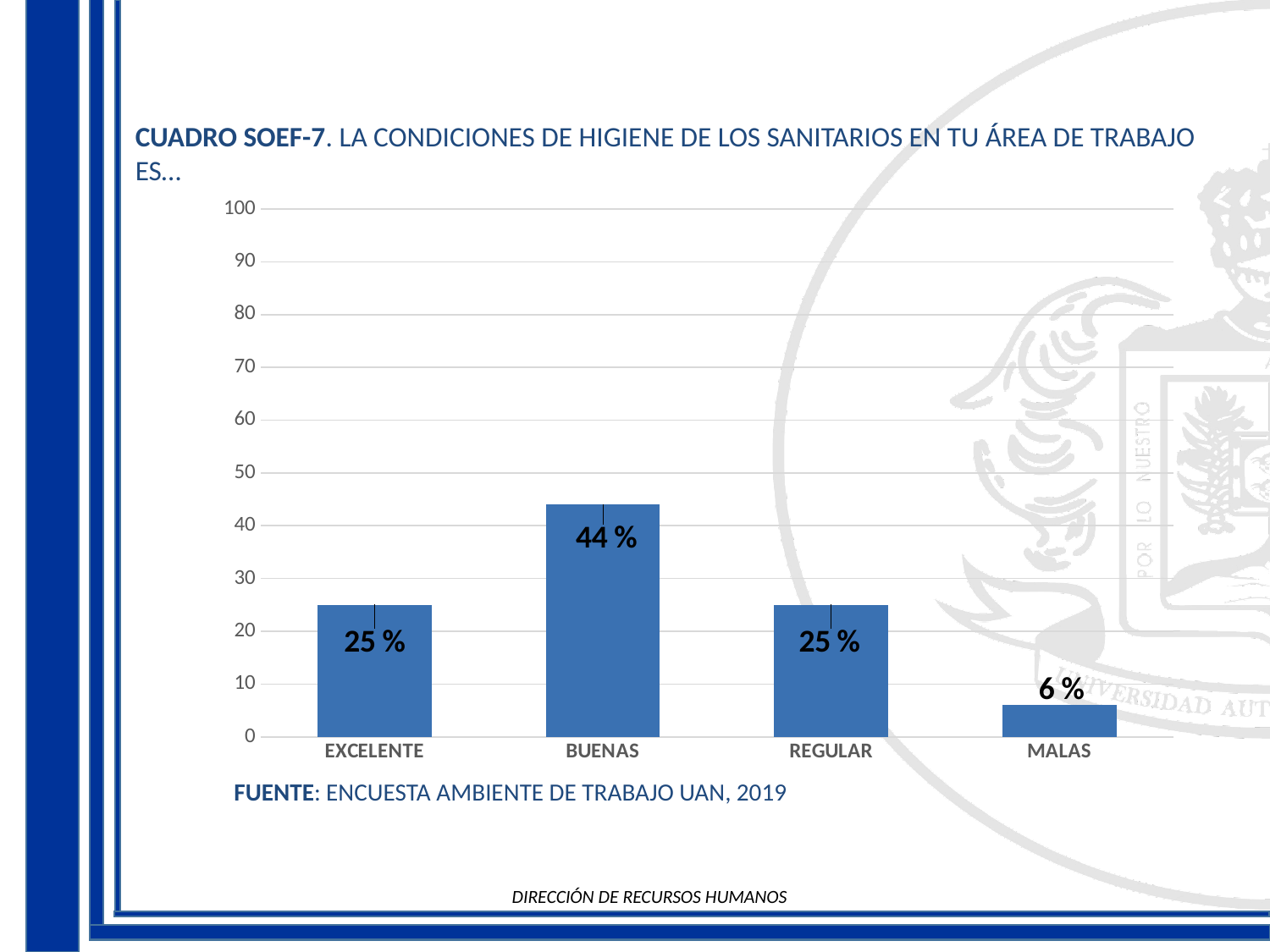
Which is larger, the value for REGULAR or the value for MALAS? REGULAR What kind of chart is shown on the slide? bar chart What is the difference between the values for BUENAS and REGULAR? 19 % What is the difference between the values for BUENAS and MALAS? 38 % Is the value for BUENAS greater or less than 50? less What source is cited below the chart? ENCUESTA AMBIENTE DE TRABAJO UAN, 2019 How many categories are shown on the x axis? 4 Which category has the lowest value? MALAS What is the value for MALAS? 6 % What is the value for EXCELENTE? 25 % What is the value for BUENAS? 44 % Which category has the highest value? BUENAS